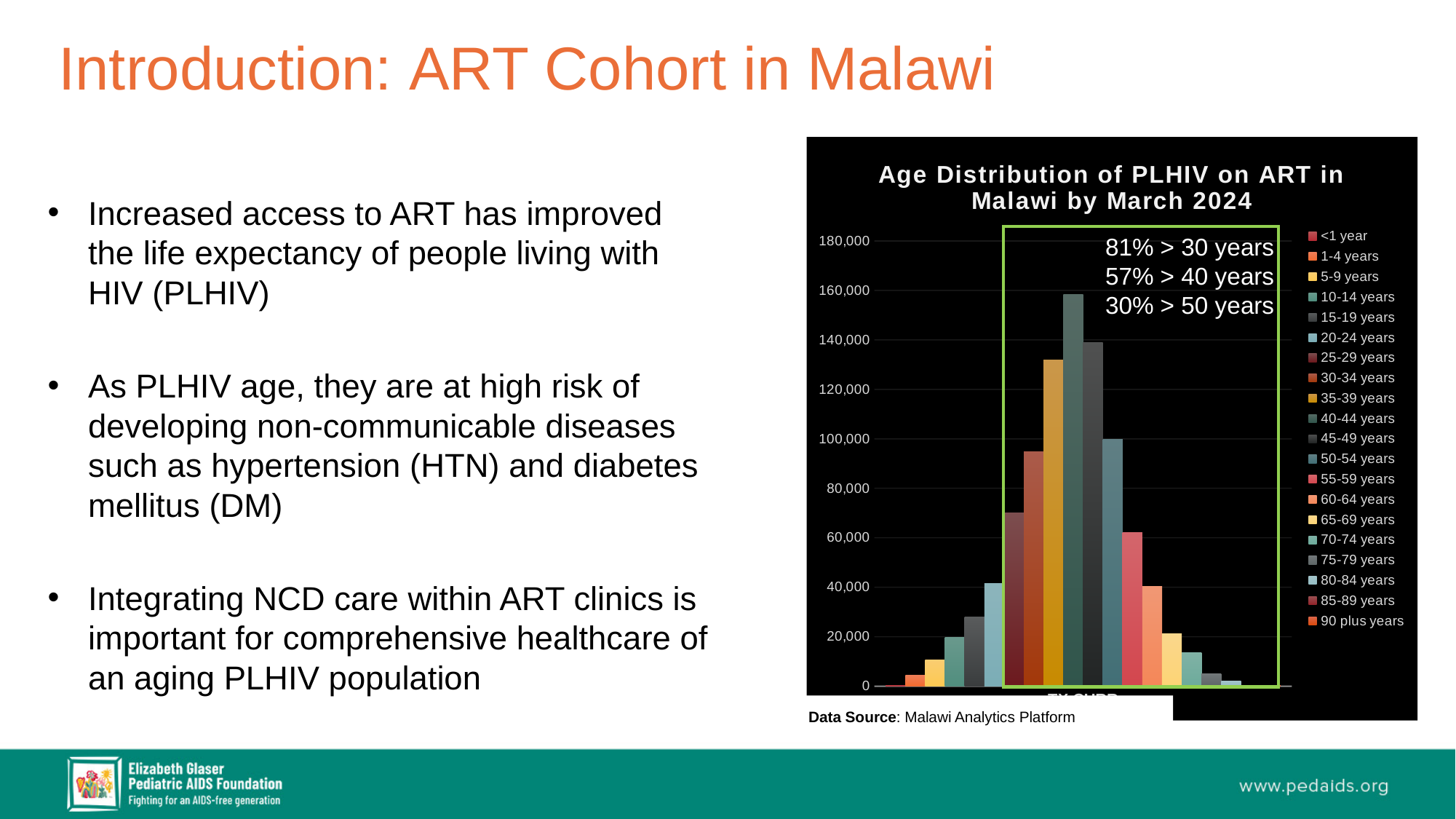
What kind of chart is shown on the slide? bar chart What is the title of the chart? Age Distribution of PLHIV on ART in Malawi by March 2024 How many age groups does the chart's legend list? 20 Is the value for 35-39 years greater or less than 120,000? greater According to the annotation on the chart, what percentage of PLHIV on ART are over 50 years? 30% Which age group has the highest number of PLHIV on ART? 40-44 years Do the values rise or fall across the age groups from 40-44 years to 90 plus years? fall Which is larger, the value for 40-44 years or the value for 45-49 years? 40-44 years Is the value for 15-19 years greater or less than 40,000? less Is the value for 25-29 years greater or less than 80,000? less